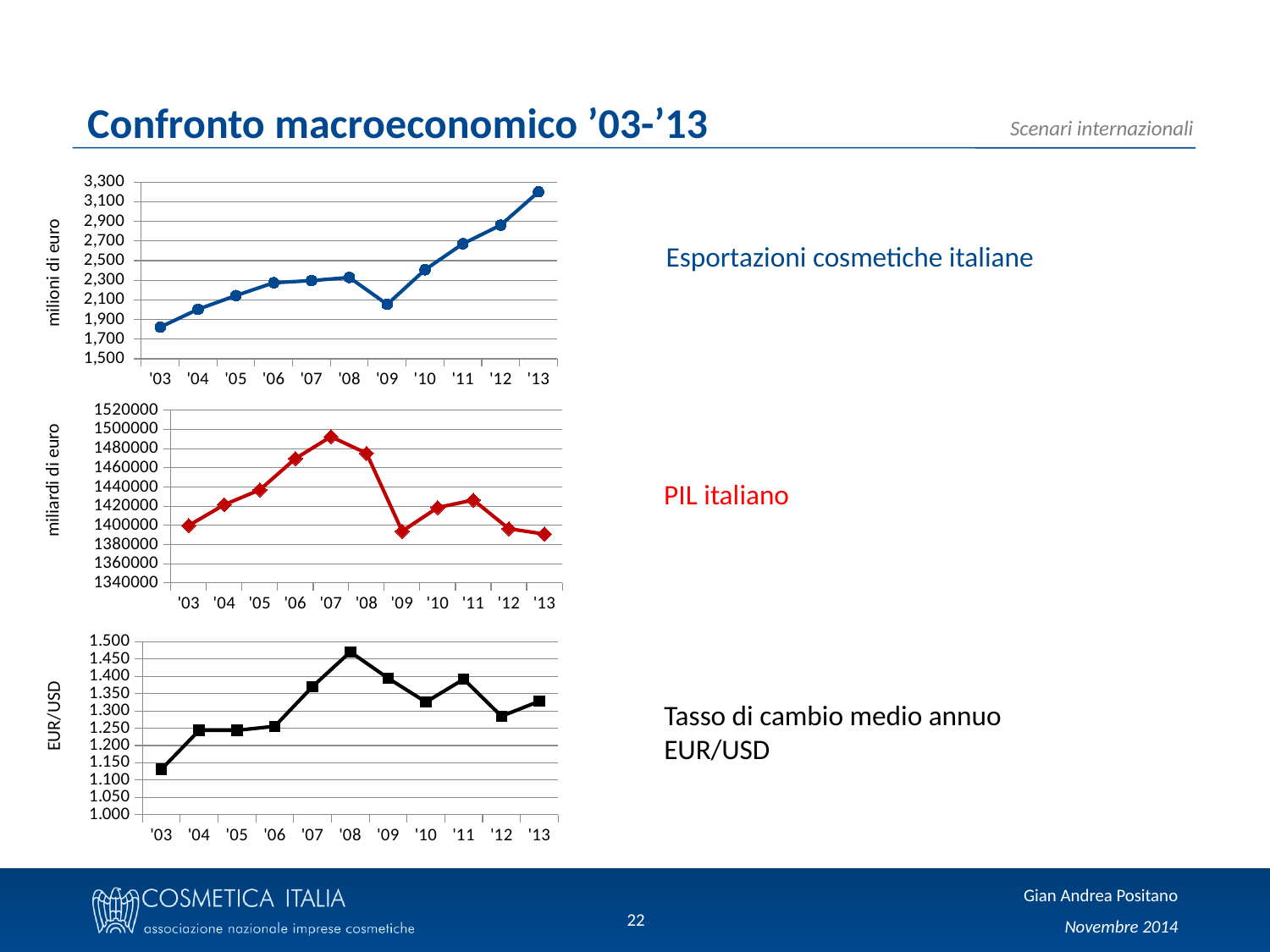
How many years are plotted on the x axis of the top chart (Esportazioni cosmetiche italiane)? 11 In the bottom chart (Tasso di cambio medio annuo EUR/USD), which year has the lowest value? '03 In the bottom chart (Tasso di cambio medio annuo EUR/USD), which year has the highest value? '08 In the top chart (Esportazioni cosmetiche italiane), is the value for '09 greater or less than 2,100? less In the bottom chart (Tasso di cambio medio annuo EUR/USD), is the value for '12 greater or less than 1.300? less In the top chart (Esportazioni cosmetiche italiane), is the value for '13 greater or less than 3,100? greater In the middle chart (PIL italiano), which year has the highest value? '07 In the top chart (Esportazioni cosmetiche italiane), which year has the highest value? '13 In the top chart (Esportazioni cosmetiche italiane), which year has the lowest value? '03 What kind of chart is the middle chart (PIL italiano)? Line chart In the middle chart (PIL italiano), which is larger, the value for '08 or the value for '10? '08